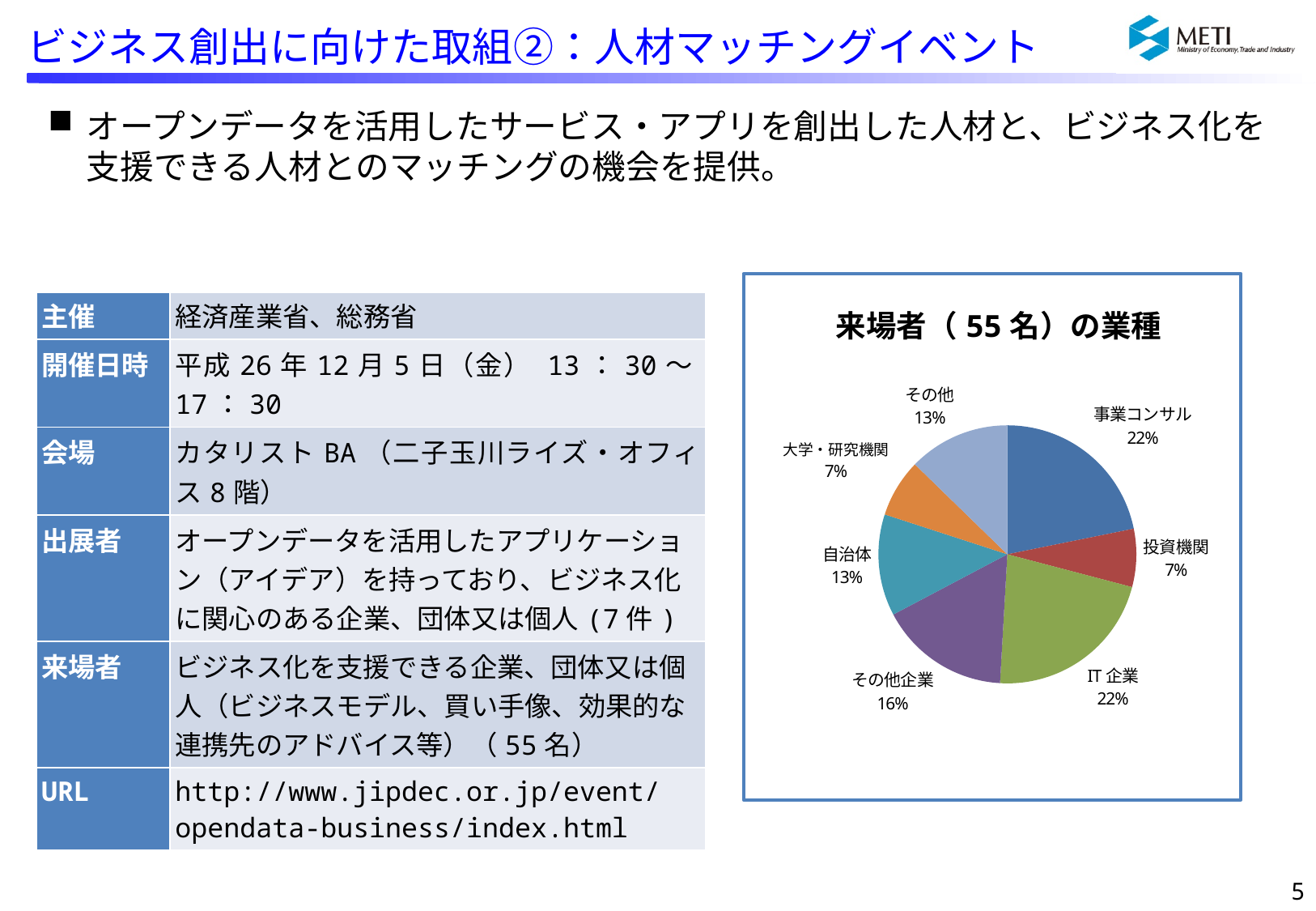
What is the title of the pie chart? 来場者（55名）の業種 What is the value shown for その他企業 in the pie chart? 16% What is the value shown for 投資機関 in the pie chart? 7% What kind of chart is shown on the slide? pie chart What share of the pie does 事業コンサル account for? 22% What is the value shown for その他 in the pie chart? 13% What is the value shown for 大学・研究機関 in the pie chart? 7% What is the value shown for IT企業 in the pie chart? 22% What is the difference in percentage points between IT企業 and その他企業? 6 What is the value shown for 自治体 in the pie chart? 13% How many slices does the pie chart have? 7 Which is larger in the pie chart, その他企業 or 自治体? その他企業